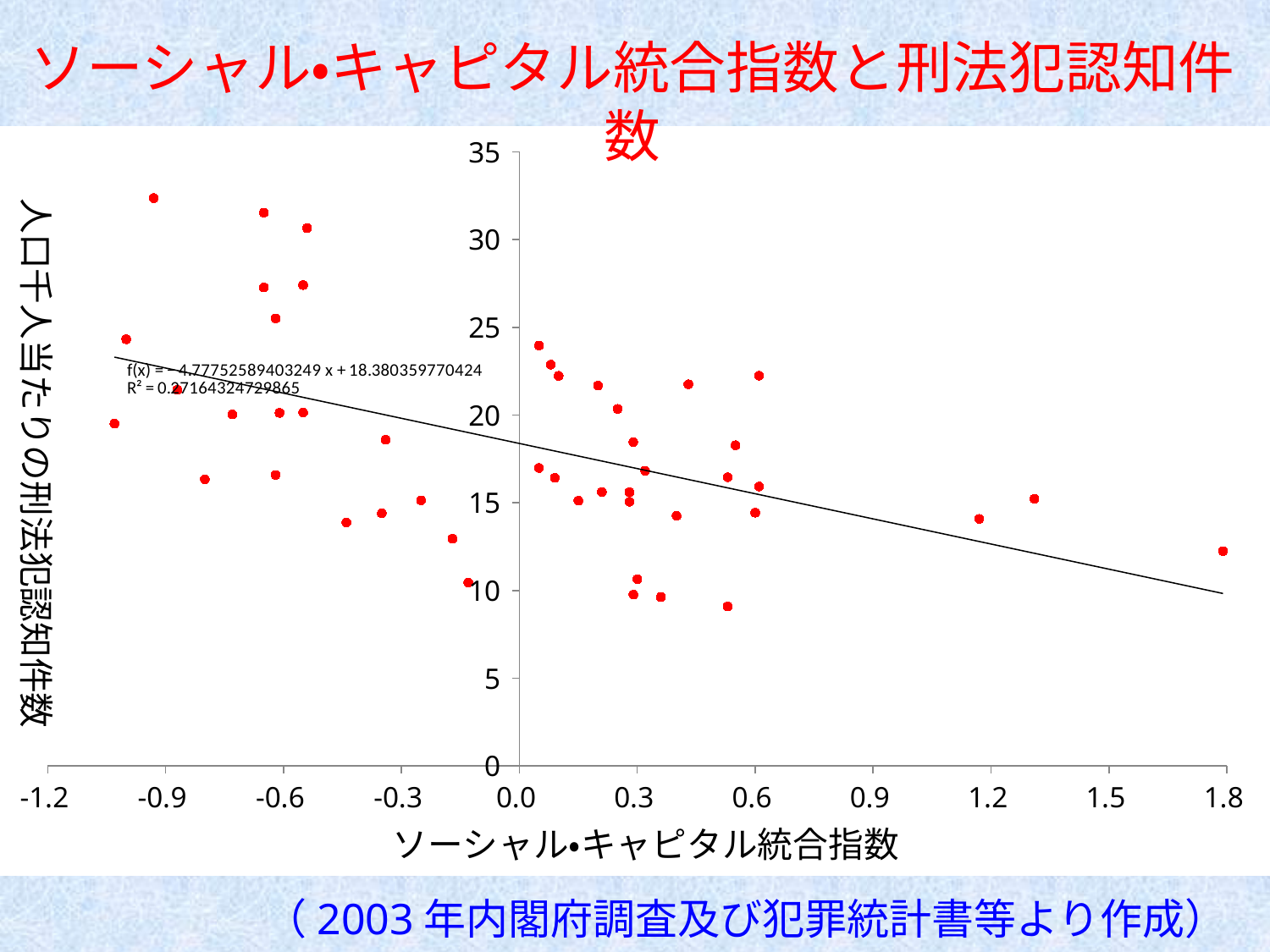
What kind of chart is shown on the slide? Scatter plot What is the label of the y axis? 人口千人当たりの刑法犯認知件数 As the ソーシャル•キャピタル統合指数 increases along the x axis, does the fitted trend line rise or fall? Fall What is the equation of the trend line printed on the chart? f(x) = -4.77752589403249 x + 18.380359770424 Is the y value of the highest data point (near x = -0.9) greater or less than 30? greater Is the y value of the rightmost data point (near x = 1.8) greater or less than 15? less What is the label of the x axis? ソーシャル•キャピタル統合指数 What is the R² value printed on the chart? 0.27164324729865 Is the y value of the lowest data point (near x = 0.55) greater or less than 15? less